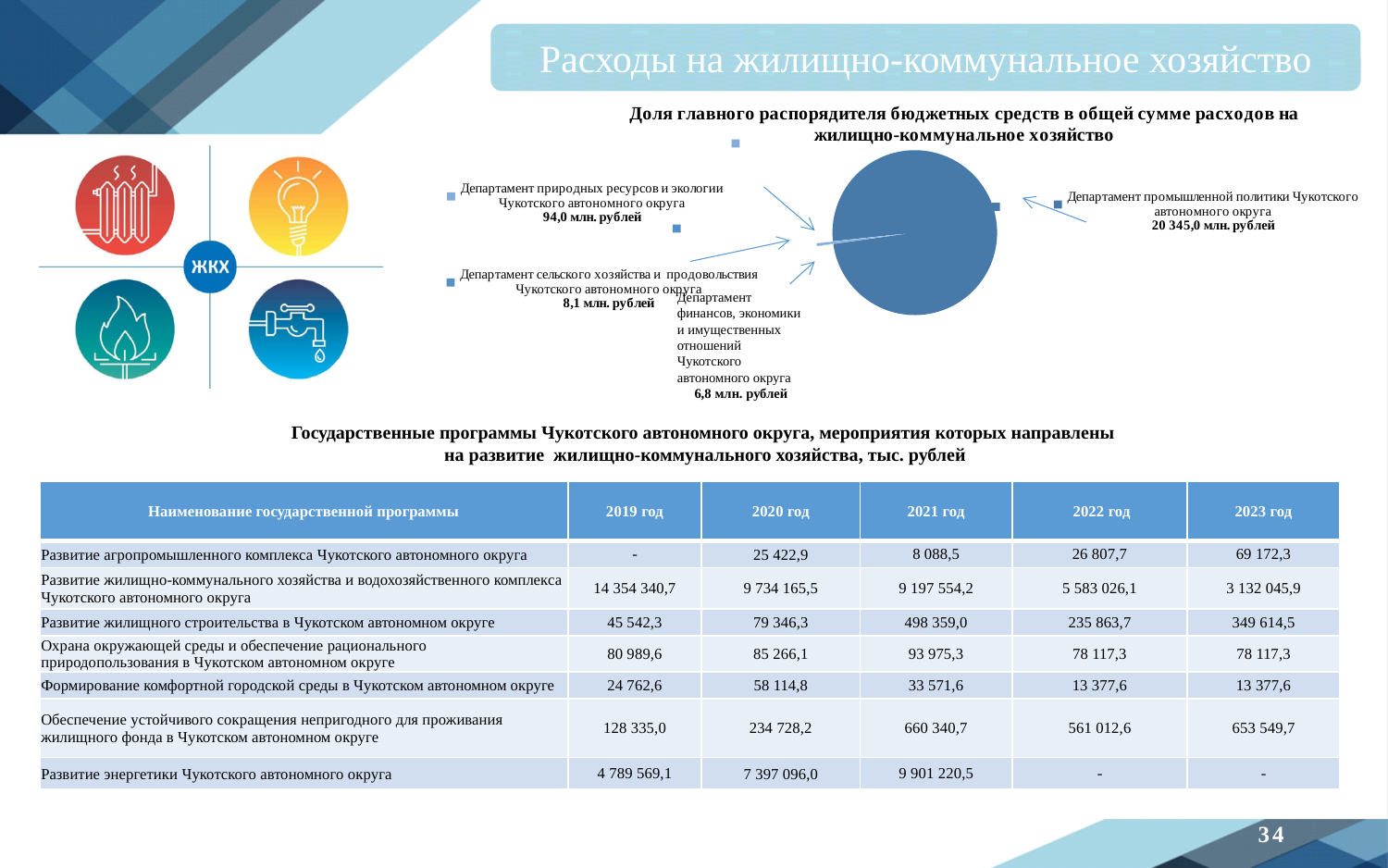
What is the title of the pie chart? Доля главного распорядителя бюджетных средств в общей сумме расходов на жилищно-коммунальное хозяйство How many departments (slices) are shown in the pie chart? 4 Which department has the largest share in the pie chart? Департамент промышленной политики Чукотского автономного округа What kind of chart is shown on the slide? pie chart What is the value for Департамент промышленной политики Чукотского автономного округа in the pie chart? 20 345,0 млн. рублей What is the value for Департамент природных ресурсов и экологии Чукотского автономного округа in the pie chart? 94,0 млн. рублей What is the value for Департамент сельского хозяйства и продовольствия Чукотского автономного округа in the pie chart? 8,1 млн. рублей What is the difference between the values for Департамент природных ресурсов и экологии and Департамент сельского хозяйства и продовольствия in the pie chart? 85,9 млн. рублей What is the value for Департамент финансов, экономики и имущественных отношений Чукотского автономного округа in the pie chart? 6,8 млн. рублей Which department has the smallest value in the pie chart? Департамент финансов, экономики и имущественных отношений Чукотского автономного округа What is the difference between the values for Департамент промышленной политики and Департамент природных ресурсов и экологии in the pie chart? 20 251,0 млн. рублей Which is larger in the pie chart: the value for Департамент сельского хозяйства и продовольствия or Департамент финансов, экономики и имущественных отношений? Департамент сельского хозяйства и продовольствия